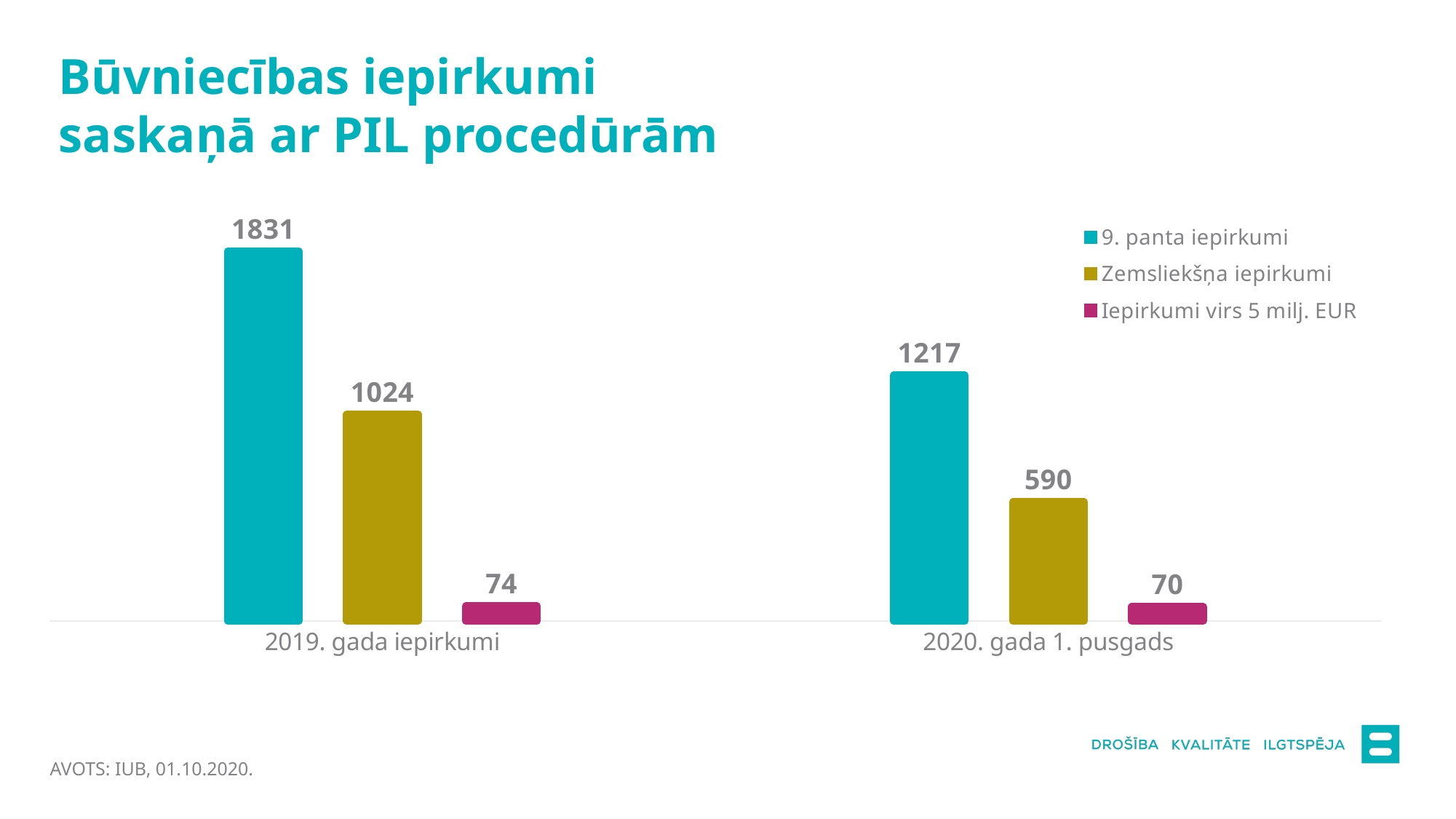
What kind of chart is shown on the slide? Bar chart How many categories are shown on the x axis? 2 Which series has the highest value in 2020. gada 1. pusgads? 9. panta iepirkumi What is the value of 9. panta iepirkumi for 2019. gada iepirkumi? 1831 How many series does the legend list? 3 What is the difference between 9. panta iepirkumi in 2019. gada iepirkumi and in 2020. gada 1. pusgads? 614 What is the value of Zemsliekšņa iepirkumi for 2020. gada 1. pusgads? 590 What colour are the bars for Iepirkumi virs 5 milj. EUR? Magenta Which series has the lowest value in 2019. gada iepirkumi? Iepirkumi virs 5 milj. EUR Which is larger: Zemsliekšņa iepirkumi in 2019. gada iepirkumi or 9. panta iepirkumi in 2020. gada 1. pusgads? 9. panta iepirkumi in 2020. gada 1. pusgads What is the value of Iepirkumi virs 5 milj. EUR for 2019. gada iepirkumi? 74 What is the difference between Zemsliekšņa iepirkumi and Iepirkumi virs 5 milj. EUR in 2020. gada 1. pusgads? 520